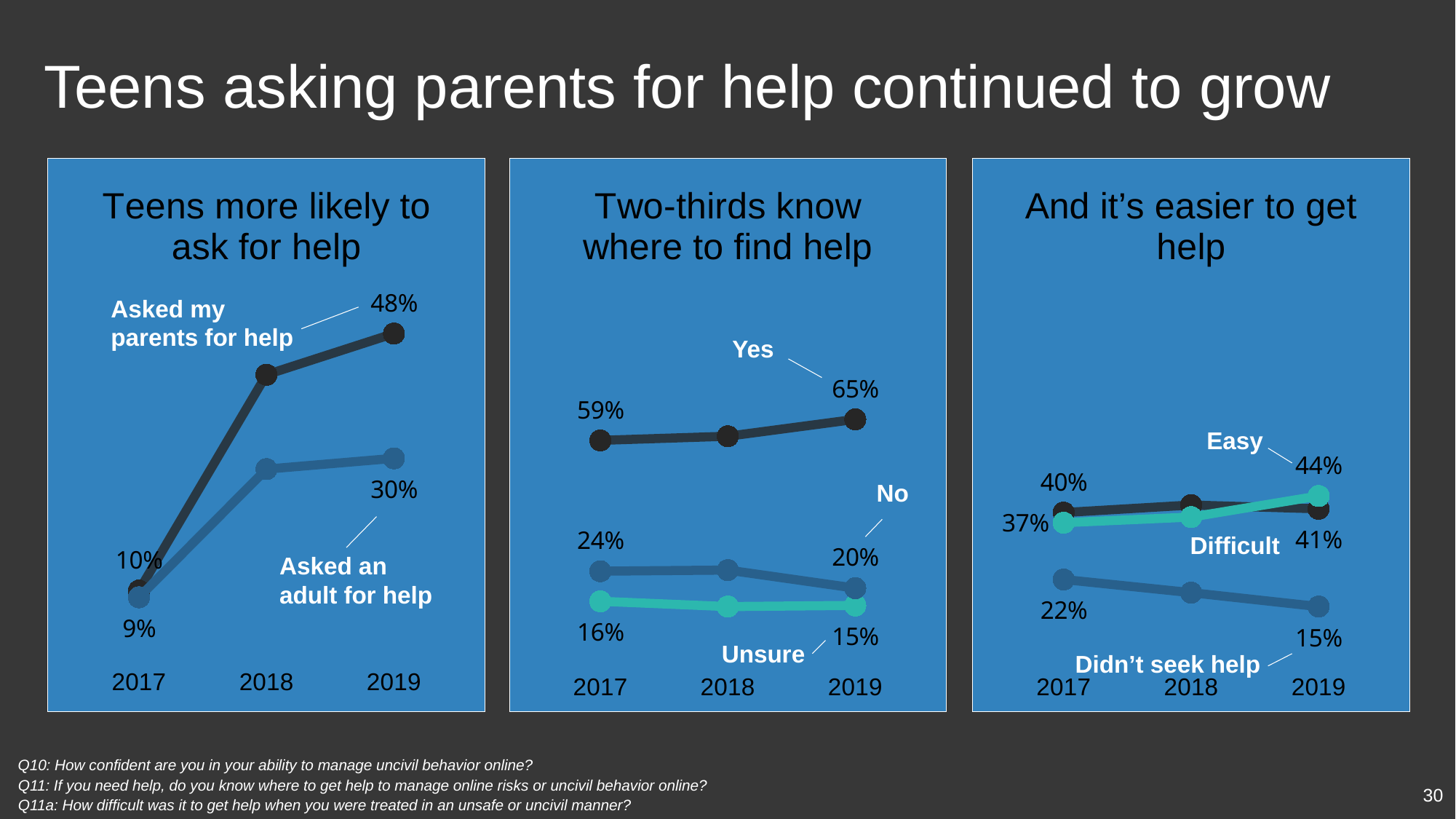
In the chart titled "Teens more likely to ask for help", does the "Asked my parents for help" line rise or fall from 2017 to 2019? Rise In the chart titled "Teens more likely to ask for help", what percentage of teens asked their parents for help in 2019? 48% In the chart titled "And it's easier to get help", which is larger in 2019: "Easy" or "Difficult"? Easy In the chart titled "Two-thirds know where to find help", how many lines are plotted? 3 In the chart titled "Two-thirds know where to find help", what was the "Yes" value in 2019? 65% In the chart titled "And it's easier to get help", what was the "Easy" value in 2019? 44% In the chart titled "Two-thirds know where to find help", what was the "Unsure" value in 2017? 16% In the chart titled "Teens more likely to ask for help", by how many percentage points did "Asked my parents for help" increase from 2017 to 2019? 38 percentage points In the chart titled "Teens more likely to ask for help", what was the value for "Asked an adult for help" in 2017? 9% In the chart titled "Two-thirds know where to find help", which response had the lowest value in 2019? Unsure What type of chart is used in the middle panel, "Two-thirds know where to find help"? Line chart In the chart titled "And it's easier to get help", what was the "Didn't seek help" value in 2017? 22%